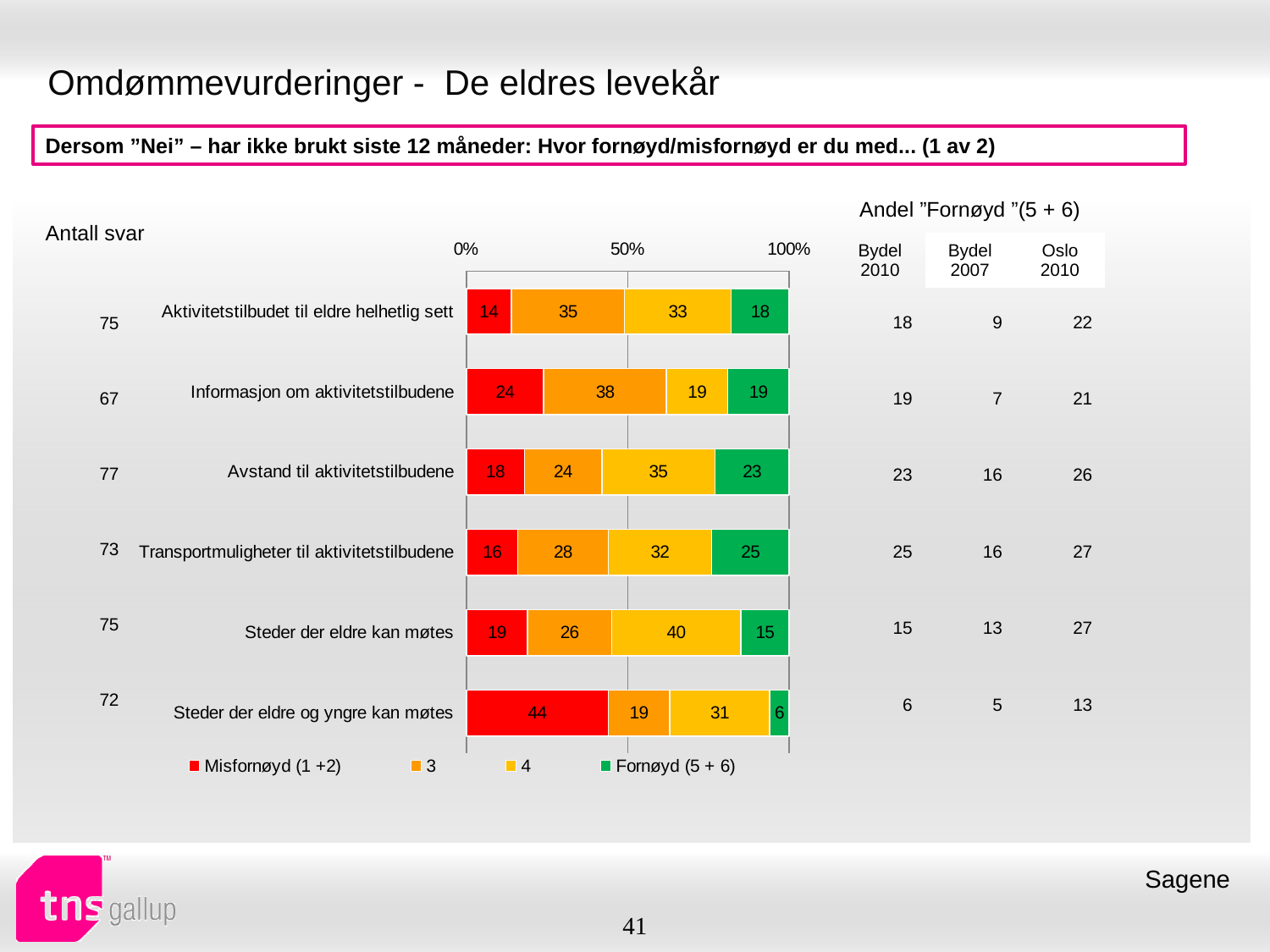
Which category has the highest Misfornøyd (1 +2) value? Steder der eldre og yngre kan møtes What kind of chart is shown on the slide? stacked bar chart What is the total of the stacked bar for 'Aktivitetstilbudet til eldre helhetlig sett'? 100 Which category has the lowest Fornøyd (5 + 6) value? Steder der eldre og yngre kan møtes What is the value of series '4' for 'Steder der eldre kan møtes'? 40 How many categories are plotted in the chart? 6 What is the Misfornøyd (1 +2) value for 'Steder der eldre og yngre kan møtes'? 44 Which colour represents Fornøyd (5 + 6) in the chart? green Which is larger: the Fornøyd (5 + 6) value for 'Avstand til aktivitetstilbudene' or for 'Steder der eldre kan møtes'? Avstand til aktivitetstilbudene How many series does the legend list? 4 What is the difference between the series '3' values for 'Informasjon om aktivitetstilbudene' and 'Aktivitetstilbudet til eldre helhetlig sett'? 3 What is the Fornøyd (5 + 6) value for 'Transportmuligheter til aktivitetstilbudene'? 25